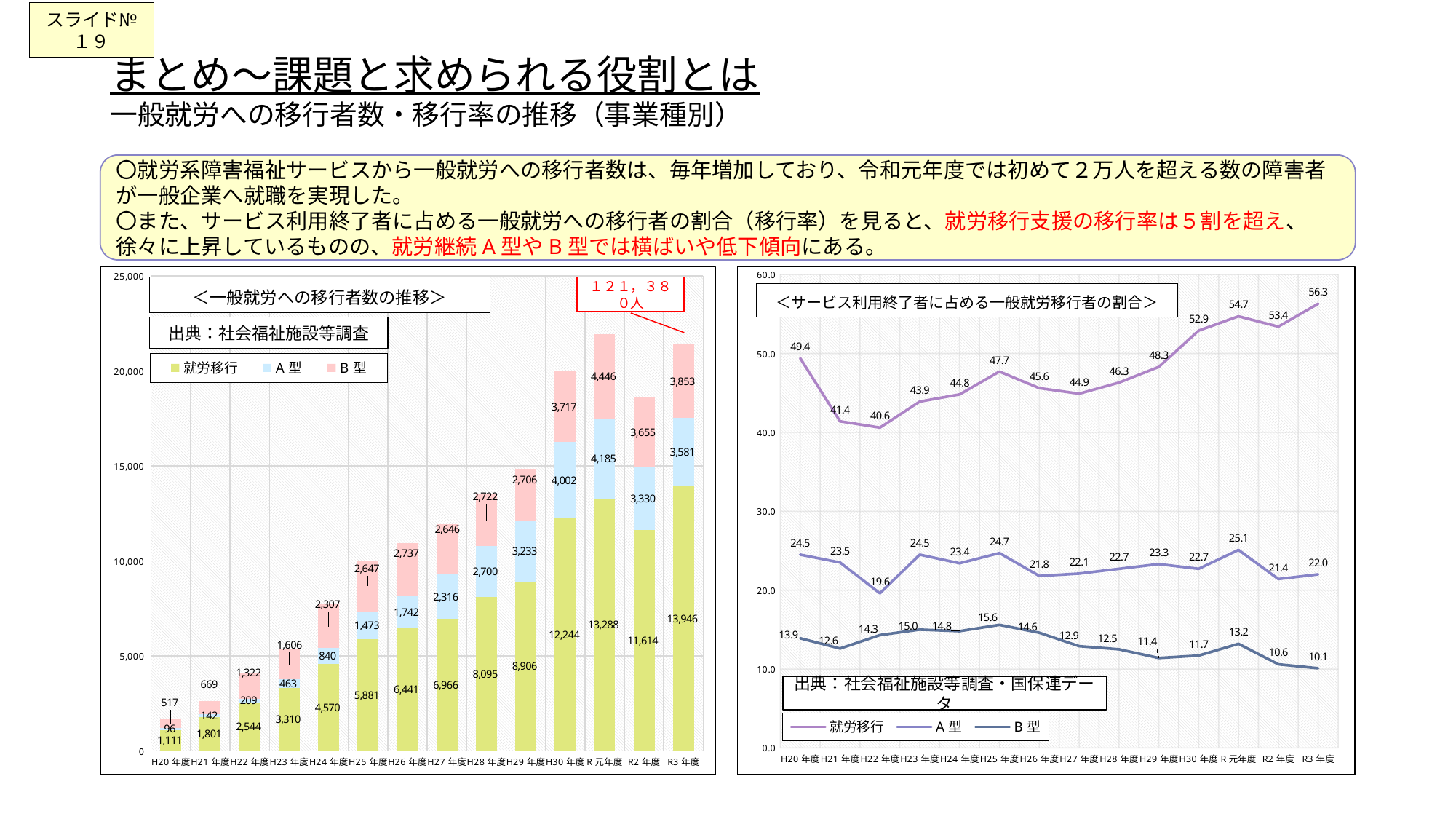
In the right chart (サービス利用終了者に占める一般就労移行者の割合), what is the value for 就労移行 in R3年度? 56.3 In the right chart (サービス利用終了者に占める一般就労移行者の割合), does the 就労移行 value rise or fall from H27年度 to R元年度? Rise What kind of chart is the left chart (一般就労への移行者数の推移)? Stacked bar chart In the left chart (一般就労への移行者数の推移), what is the total of the stacked bar for R3年度? 21,380 In the left chart (一般就労への移行者数の推移), what is the difference between the B型 value in R元年度 and in R2年度? 791 How many years (categories) are shown on the x axis of the left chart (一般就労への移行者数の推移)? 14 In the left chart (一般就労への移行者数の推移), what is the value for 就労移行 in R3年度? 13,946 How many series does the legend of the right chart (サービス利用終了者に占める一般就労移行者の割合) list? 3 In the right chart (サービス利用終了者に占める一般就労移行者の割合), what is the value for A型 in H22年度? 19.6 In the left chart (一般就労への移行者数の推移), which is larger: the 就労移行 value in H30年度 or in R2年度? H30年度 In the right chart (サービス利用終了者に占める一般就労移行者の割合), in which year is the B型 value lowest? R3年度 In the right chart (サービス利用終了者に占める一般就労移行者の割合), in which year is the 就労移行 value highest? R3年度